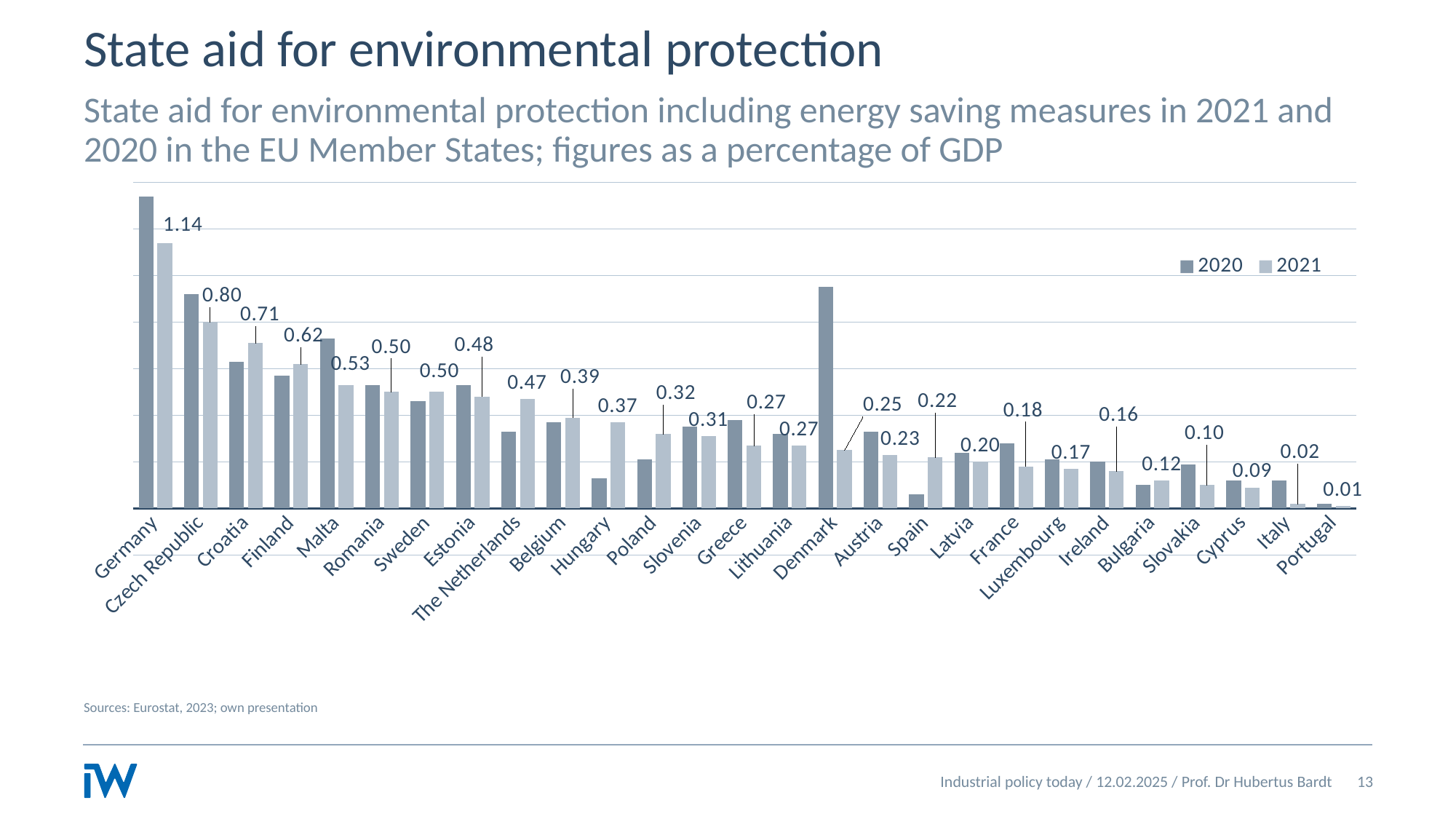
What is the 2021 value for Denmark? 0.25 What is the 2021 value for the Czech Republic? 0.80 Which country has the lowest 2021 value? Portugal How many series does the legend list? 2 What is the difference between the 2021 values for Germany and the Czech Republic? 0.34 Do the 2021 values rise or fall from left to right along the x axis? Fall What is the 2021 value for Portugal? 0.01 Which is larger, the 2020 value for Denmark or the 2020 value for Austria? Denmark What kind of chart is shown on the slide? Bar chart What is the 2021 value for Germany? 1.14 Which country has the highest 2021 value? Germany How many countries are shown on the x axis? 27